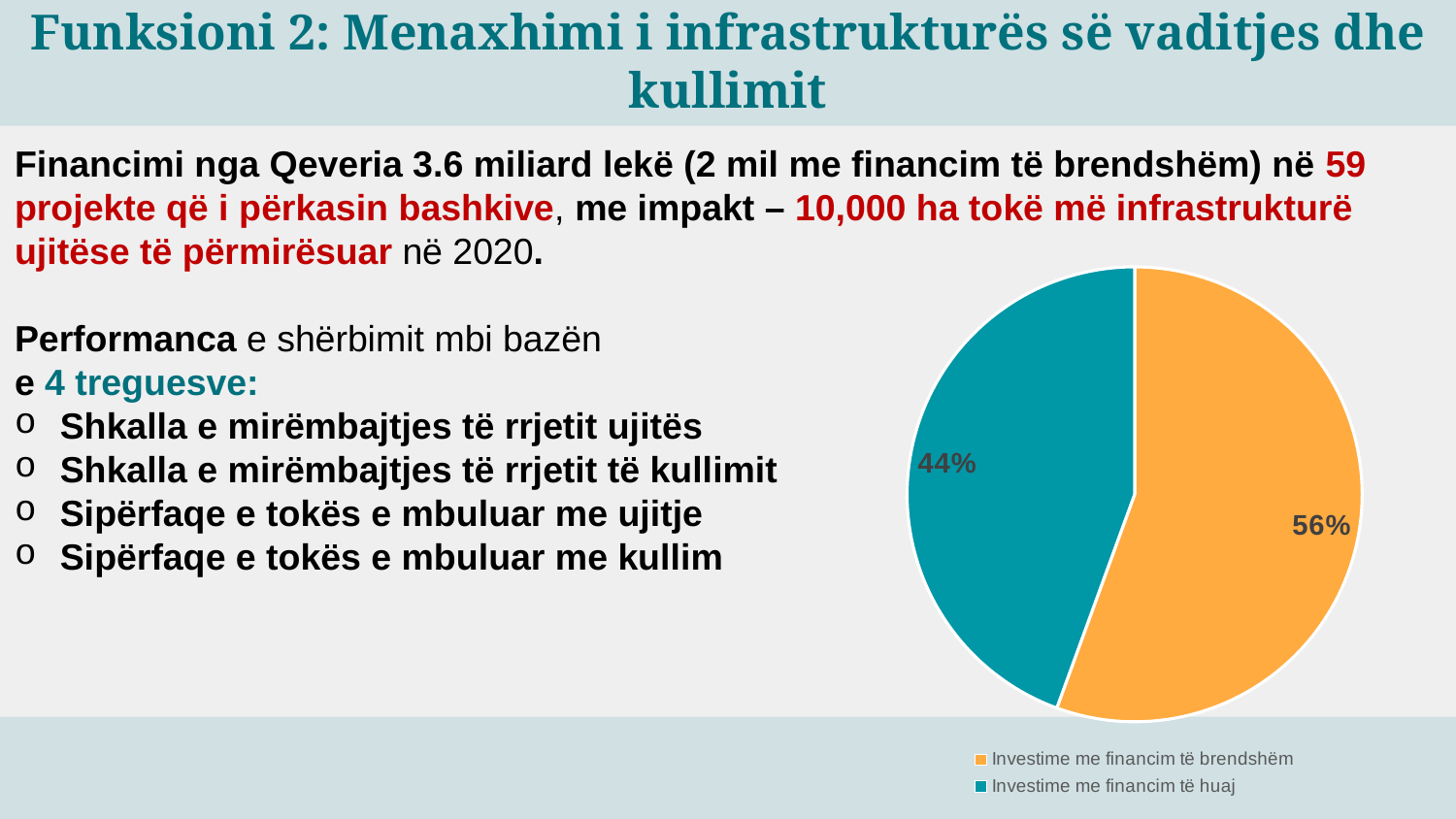
What share of the pie is labelled 'Investime me financim të brendshëm'? 56% What kind of chart is shown on the slide? pie chart What colour is the 'Investime me financim të brendshëm' slice of the pie? orange Which is larger: the share for 'Investime me financim të brendshëm' or the share for 'Investime me financim të huaj'? Investime me financim të brendshëm What colour is the 'Investime me financim të huaj' slice of the pie? teal How many slices does the pie chart have? 2 Which slice of the pie is the largest? Investime me financim të brendshëm What is the difference in percentage points between the 'Investime me financim të brendshëm' slice and the 'Investime me financim të huaj' slice? 12 percentage points How many entries does the legend of the pie chart list? 2 What share of the pie is labelled 'Investime me financim të huaj'? 44% Which slice of the pie is the smallest? Investime me financim të huaj